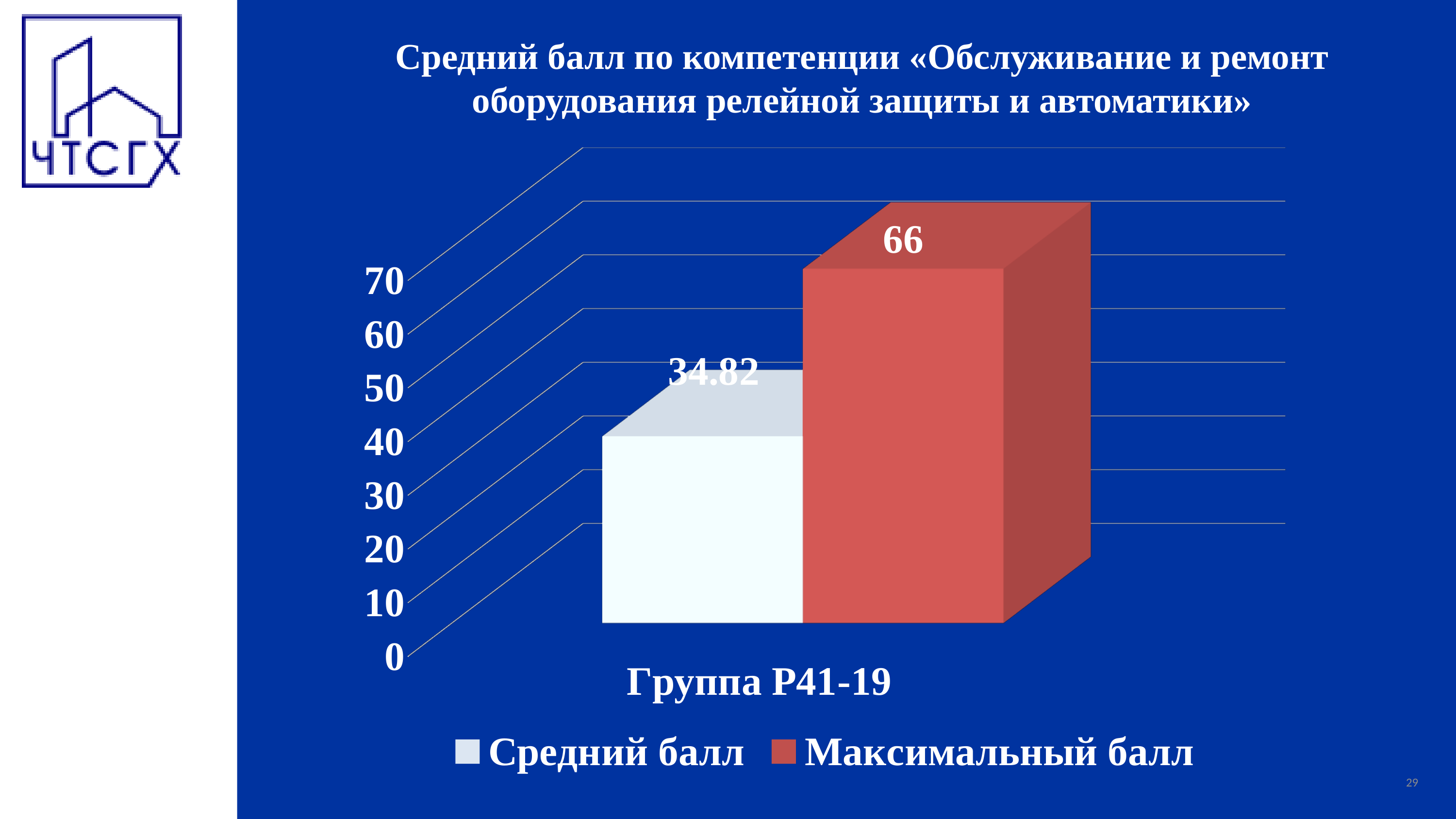
What is the highest tick value shown on the vertical axis? 70 Is the value of Максимальный балл for Группа Р41-19 greater or less than 60? greater What is the name of the category shown on the x axis? Группа Р41-19 Is the value of Средний балл for Группа Р41-19 greater or less than 40? less What is the difference between Максимальный балл and Средний балл for Группа Р41-19? 31.18 How many series does the legend list? 2 Which series is shown in red? Максимальный балл What is the value of Средний балл for Группа Р41-19? 34.82 What is the value of Максимальный балл for Группа Р41-19? 66 What kind of chart is shown on the slide? Bar chart How many categories are shown on the x axis? 1 Which series has the higher value for Группа Р41-19, Средний балл or Максимальный балл? Максимальный балл